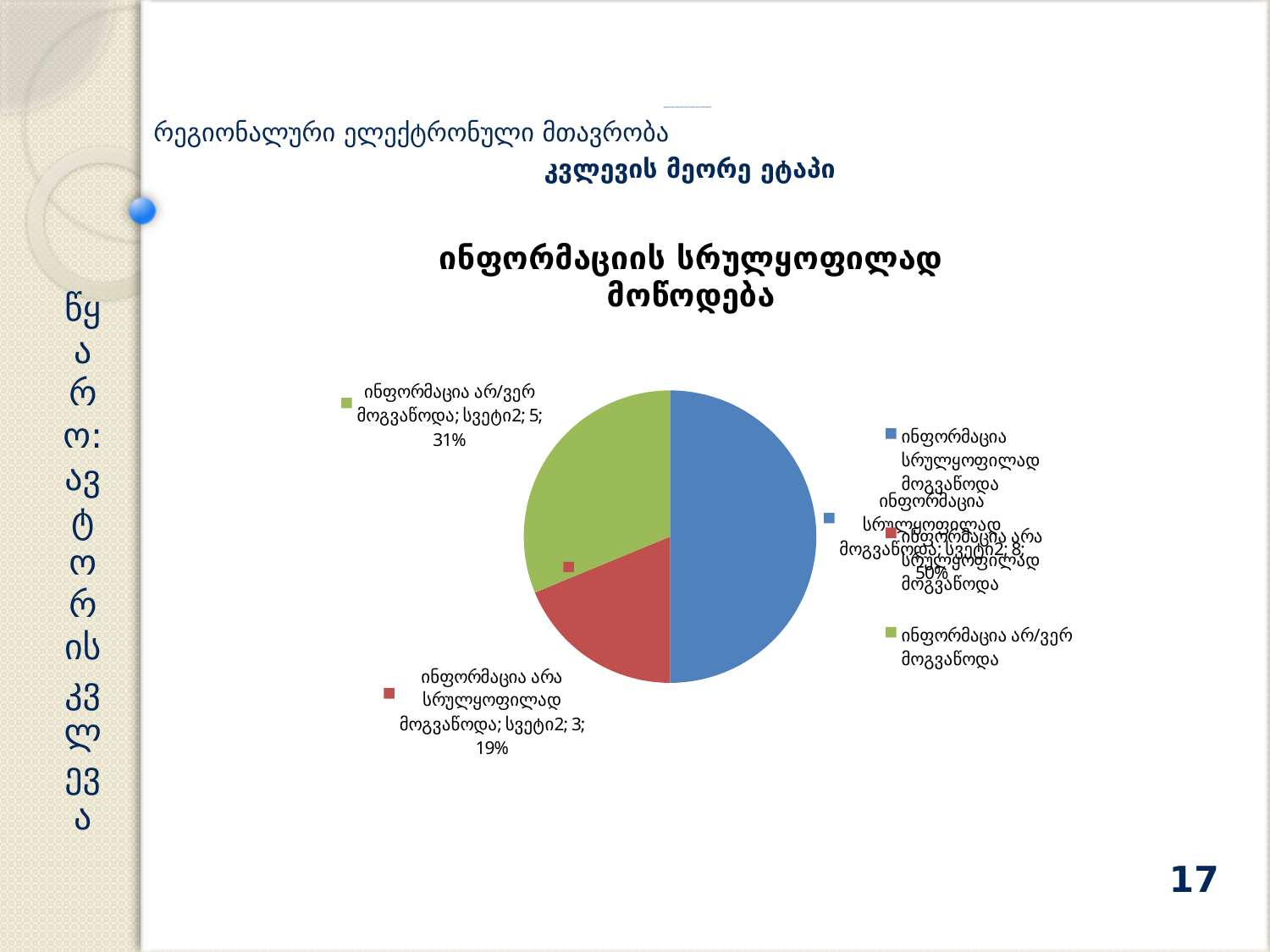
Which slice is the smallest in the pie chart? ინფორმაცია არა სრულყოფილად მოგვაწოდა What share of the pie does "ინფორმაცია არა სრულყოფილად მოგვაწოდა" represent? 19% What share of the pie does "ინფორმაცია სრულყოფილად მოგვაწოდა" represent? 50% Which slice is the largest in the pie chart? ინფორმაცია სრულყოფილად მოგვაწოდა What share of the pie does "ინფორმაცია არ/ვერ მოგვაწოდა" represent? 31% What kind of chart is shown on the slide? pie chart What is the difference between the values for "ინფორმაცია არ/ვერ მოგვაწოდა" and "ინფორმაცია არა სრულყოფილად მოგვაწოდა"? 2 What colour is the slice for "ინფორმაცია არ/ვერ მოგვაწოდა"? green How many slices does the pie chart have? 3 What is the value for the slice "ინფორმაცია არა სრულყოფილად მოგვაწოდა"? 3 What is the value for the slice "ინფორმაცია არ/ვერ მოგვაწოდა"? 5 What is the value for the slice "ინფორმაცია სრულყოფილად მოგვაწოდა"? 8